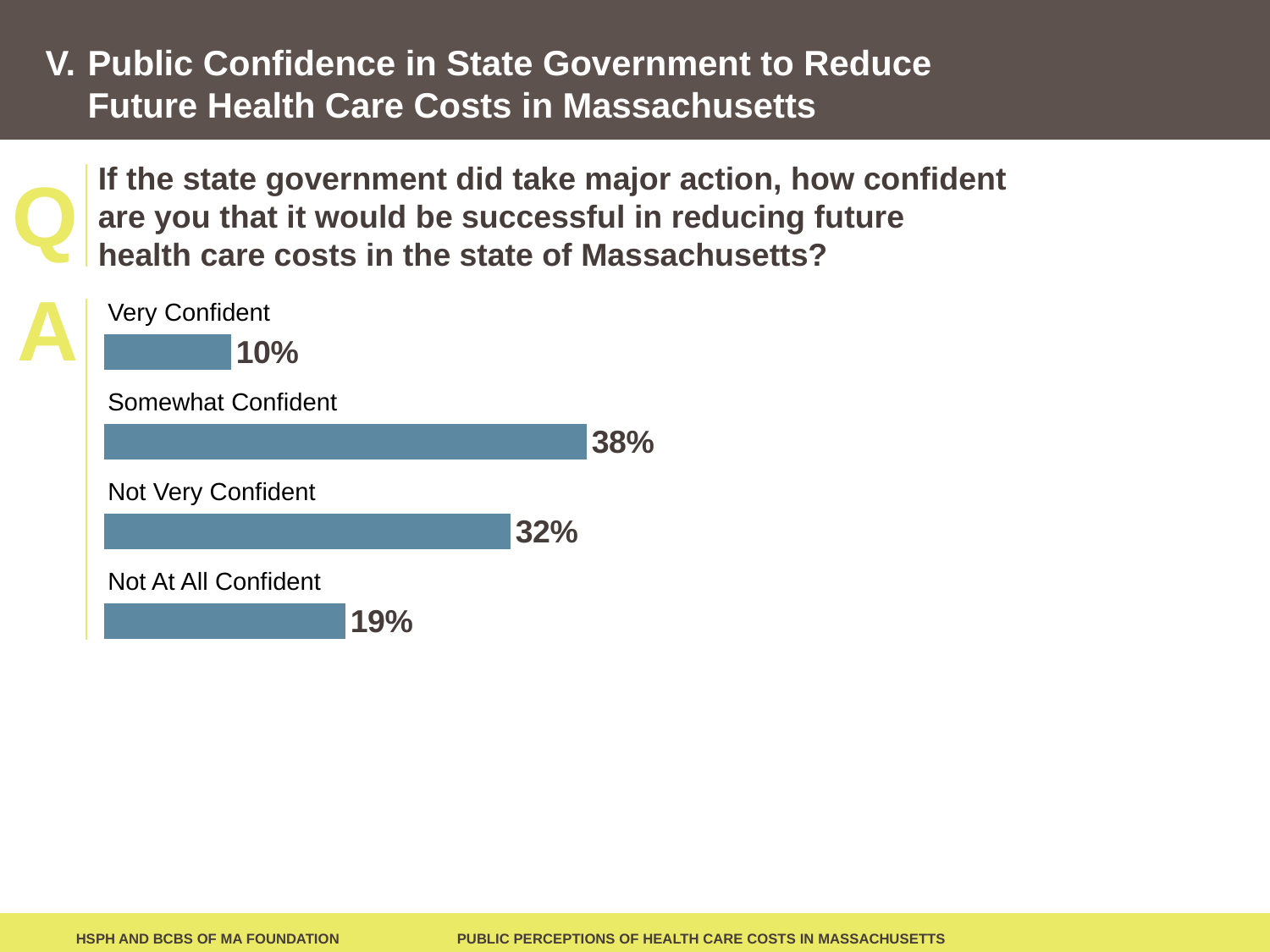
Which is larger, the percentage for Not Very Confident or for Not At All Confident? Not Very Confident What kind of chart is shown on the slide? Bar chart How many response categories are shown in the chart? 4 What is the difference in percentage points between Somewhat Confident and Not Very Confident? 6 Which response category has the highest percentage? Somewhat Confident What percentage of respondents said they were Not At All Confident? 19% What percentage of respondents said they were Not Very Confident? 32% What percentage of respondents said they were Very Confident? 10% What percentage of respondents said they were Somewhat Confident? 38% What is the difference in percentage points between Not At All Confident and Very Confident? 9 What colour are the bars in the chart? Blue Which response category has the lowest percentage? Very Confident